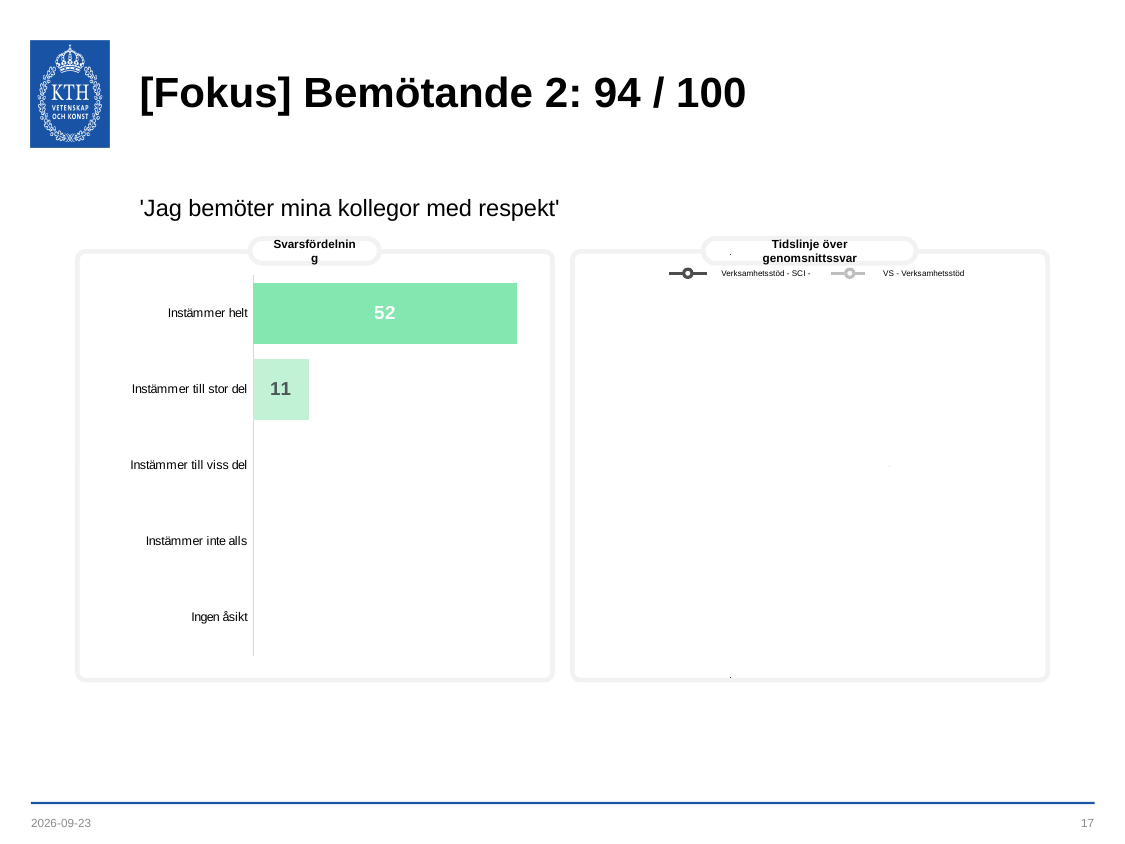
What survey statement is shown above the charts on the slide? 'Jag bemöter mina kollegor med respekt' In the Svarsfördelning chart, what is the combined value of 'Instämmer helt' and 'Instämmer till stor del'? 63 How many series does the legend of the 'Tidslinje över genomsnittssvar' chart list? 2 In the Svarsfördelning chart, what is the value for 'Instämmer helt'? 52 In the Svarsfördelning chart, what is the value for 'Instämmer till stor del'? 11 In the Svarsfördelning chart, which is larger: the value for 'Instämmer helt' or for 'Instämmer till stor del'? Instämmer helt What is the title of the chart on the right side of the slide? Tidslinje över genomsnittssvar In the Svarsfördelning chart, what is the difference between the values for 'Instämmer helt' and 'Instämmer till stor del'? 41 How many categories are listed on the axis of the Svarsfördelning chart? 5 What kind of chart is the Svarsfördelning chart on the left? Bar chart In the Svarsfördelning chart, which category has the highest value? Instämmer helt